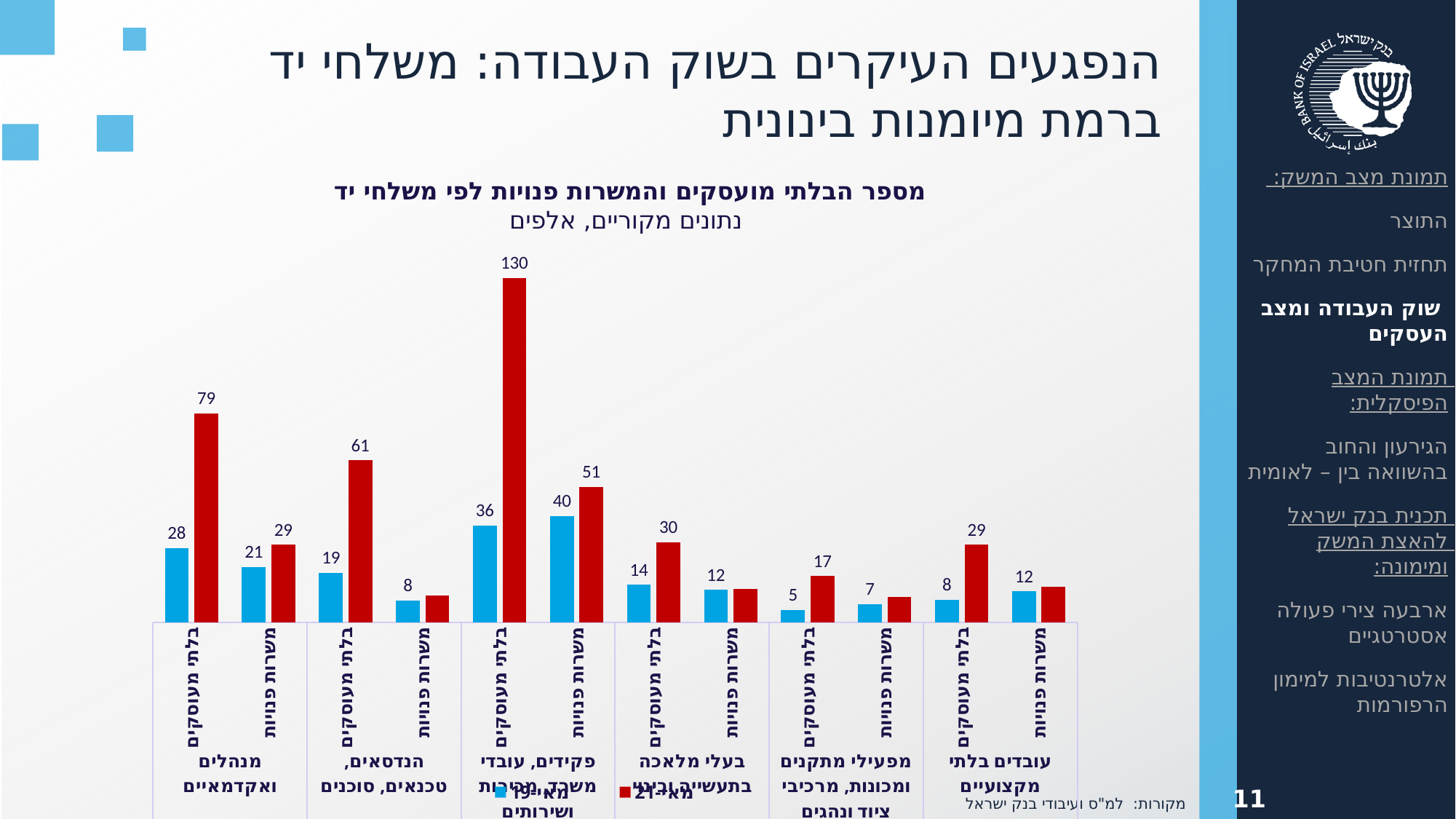
What type of chart is shown on the slide? bar chart What is the value of the מאי-19 bar for בלתי מועסקים in the מנהלים ואקדמאיים group? 28 How many occupation groups are shown along the x axis? 6 What is the value of the מאי-19 bar for בלתי מועסקים in the מפעילי מתקנים ומכונות, מרכיבי ציוד ונהגים group? 5 How many series does the legend list? 2 Which bar in the chart has the highest value? מאי-21, בלתי מועסקים, פקידים, עובדי משרד, מכירות ושירותים (130) What is the value of the מאי-21 bar for משרות פנויות in the פקידים, עובדי משרד, מכירות ושירותים group? 51 What is the difference between the מאי-21 and מאי-19 values for בלתי מועסקים in the מנהלים ואקדמאיים group? 51 Which is larger: the מאי-21 value for בלתי מועסקים in the בעלי מלאכה בתעשייה ובינוי group or the מאי-21 value for בלתי מועסקים in the מפעילי מתקנים ומכונות, מרכיבי ציוד ונהגים group? בעלי מלאכה בתעשייה ובינוי (30) What is the value of the מאי-21 bar for בלתי מועסקים in the פקידים, עובדי משרד, מכירות ושירותים group? 130 What are the two series named in the legend? מאי-19 and מאי-21 What is the difference between the מאי-21 and מאי-19 values for בלתי מועסקים in the הנדסאים, טכנאים, סוכנים group? 42